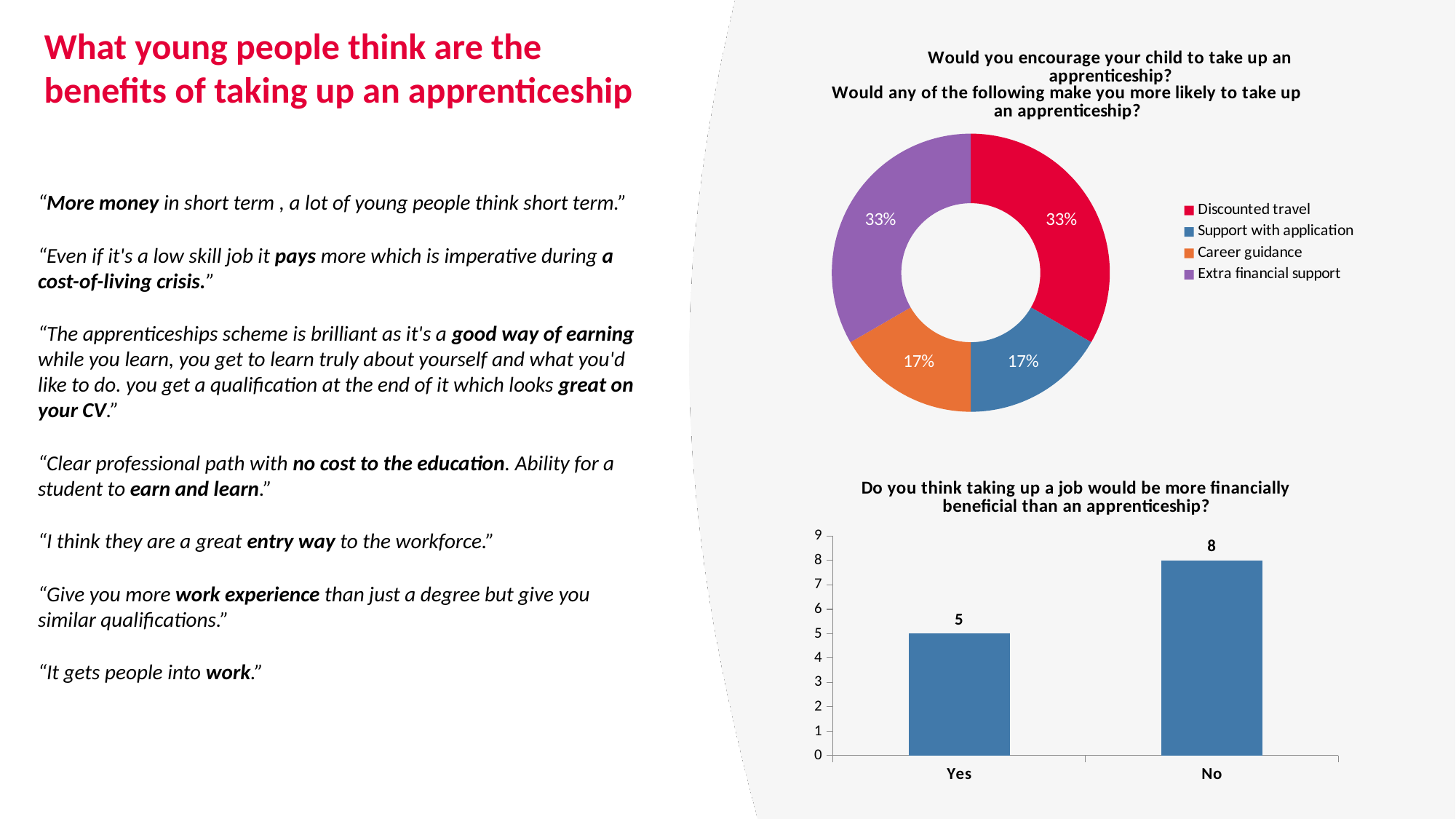
In the bar chart 'Do you think taking up a job would be more financially beneficial than an apprenticeship?', what is the value for 'Yes'? 5 In the bar chart 'Do you think taking up a job would be more financially beneficial than an apprenticeship?', which category has the highest value? No In the bar chart 'Do you think taking up a job would be more financially beneficial than an apprenticeship?', what is the value for 'No'? 8 In the bar chart 'Do you think taking up a job would be more financially beneficial than an apprenticeship?', what is the difference between the values for 'No' and 'Yes'? 3 In the doughnut chart at the top right, which is larger: 'Support with application' or 'Extra financial support'? Extra financial support How many entries does the legend of the doughnut chart at the top right list? 4 In the doughnut chart at the top right, what colour is the 'Career guidance' segment? Orange In the doughnut chart at the top right, what share is shown for 'Extra financial support'? 33% What kind of chart is the lower chart on the slide? Bar chart In the doughnut chart at the top right, what share is shown for 'Discounted travel'? 33% In the doughnut chart at the top right, what share is shown for 'Career guidance'? 17% In the bar chart 'Do you think taking up a job would be more financially beneficial than an apprenticeship?', how many categories are shown? 2